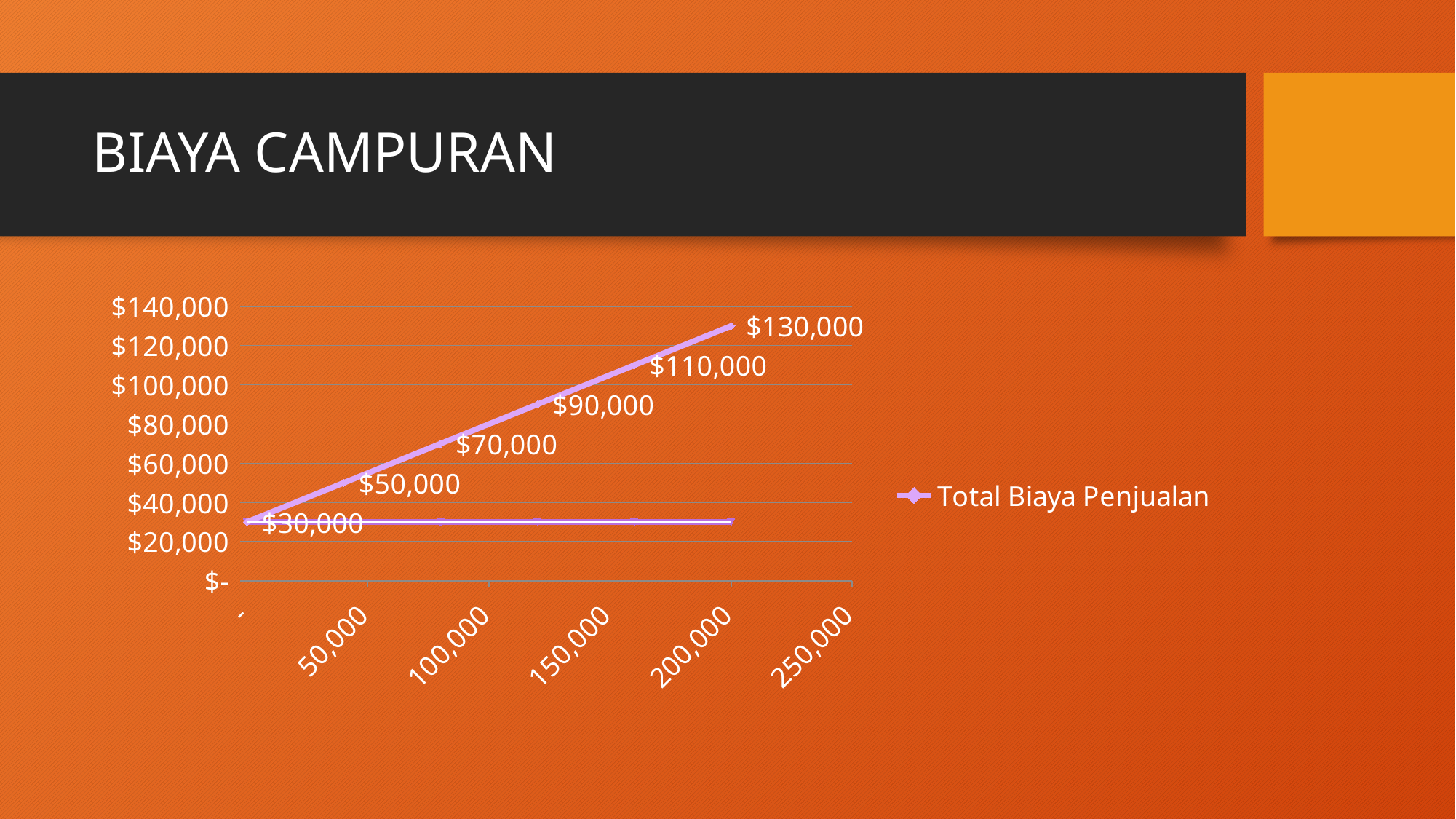
What is the difference between the highest and lowest labelled values of Total Biaya Penjualan? $100,000 What is the value of Total Biaya Penjualan at the start of the x axis (0)? $30,000 What kind of chart is shown on the slide? line chart What is the name of the series shown in the legend? Total Biaya Penjualan What is the value of Total Biaya Penjualan at 200,000 on the x axis? $130,000 What is the lowest labelled value of Total Biaya Penjualan? $30,000 How many series does the legend list? 1 How many data labels are printed along the rising line? 6 What is the difference between the $110,000 and $90,000 data points? $20,000 What is the highest labelled value of Total Biaya Penjualan? $130,000 Does Total Biaya Penjualan rise or fall as the x-axis value increases? rise What is the title of the slide containing the chart? BIAYA CAMPURAN